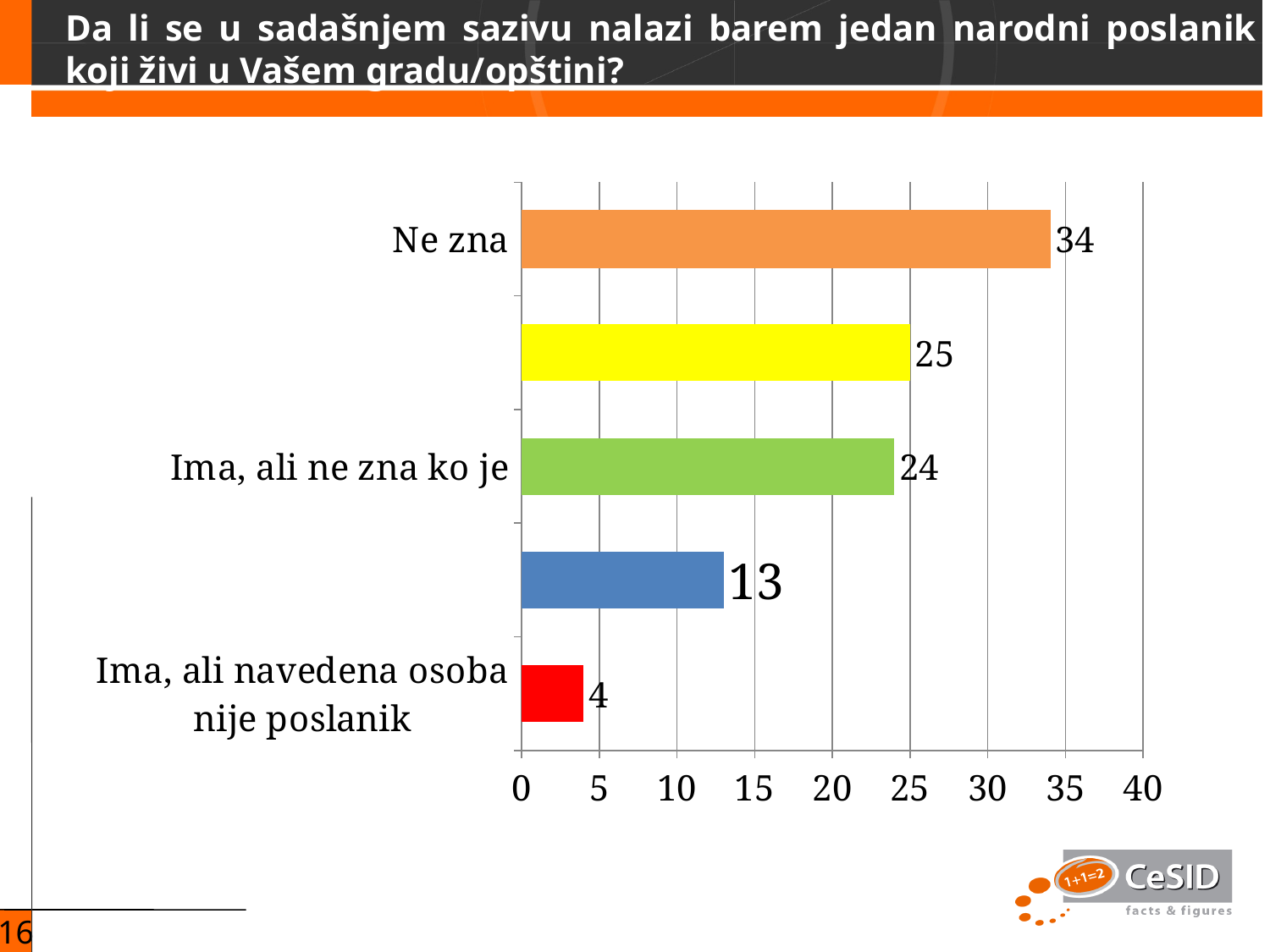
How many bars are plotted in the chart? 5 What colour is the bar for "Ne zna"? orange What is the value for "Ne zna"? 34 What kind of chart is shown on the slide? bar chart Which category has the highest value? Ne zna Is the value for "Ne zna" greater or less than 30? greater What is the value for "Ima, ali ne zna ko je"? 24 What is the difference between the values for "Ne zna" and "Ima, ali ne zna ko je"? 10 Which is larger, the value for "Ne zna" or the value for "Ima, ali ne zna ko je"? Ne zna Which category has the lowest value? Ima, ali navedena osoba nije poslanik What is the value for "Ima, ali navedena osoba nije poslanik"? 4 What is the difference between the values for "Ima, ali ne zna ko je" and "Ima, ali navedena osoba nije poslanik"? 20